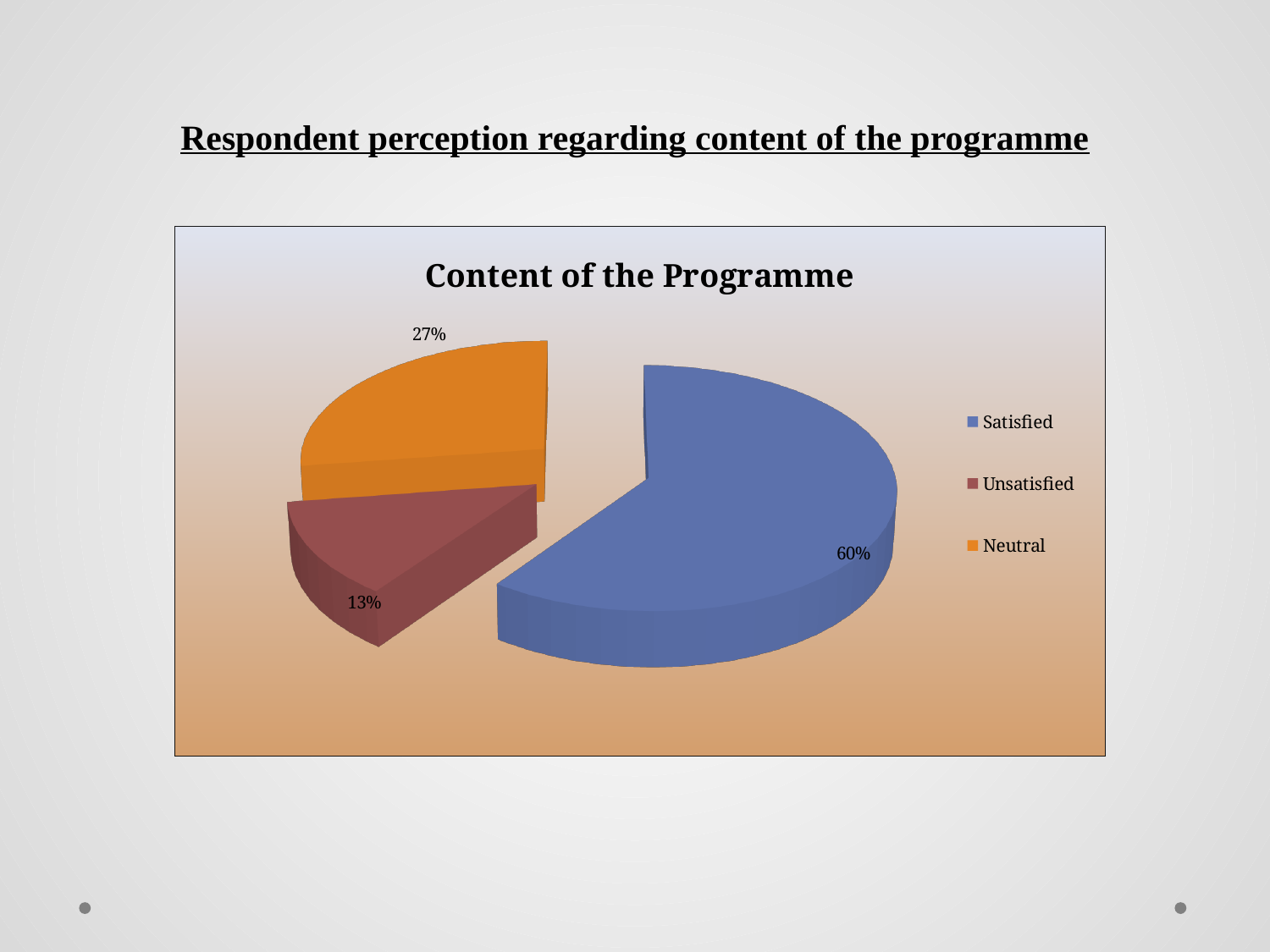
Which category has the smallest share of the pie? Unsatisfied Which category has the largest share of the pie? Satisfied What percentage of respondents were Neutral? 27% How many categories are shown in the pie chart? 3 Which colour represents the Neutral category in the chart? Orange What is the difference in percentage points between Satisfied and Neutral? 33 What percentage of respondents were Satisfied with the content of the programme? 60% Which is larger, the Neutral share or the Unsatisfied share? Neutral What is the title of the chart? Content of the Programme What percentage of respondents were Unsatisfied? 13% What kind of chart is shown on the slide? Pie chart What is the difference in percentage points between Neutral and Unsatisfied? 14